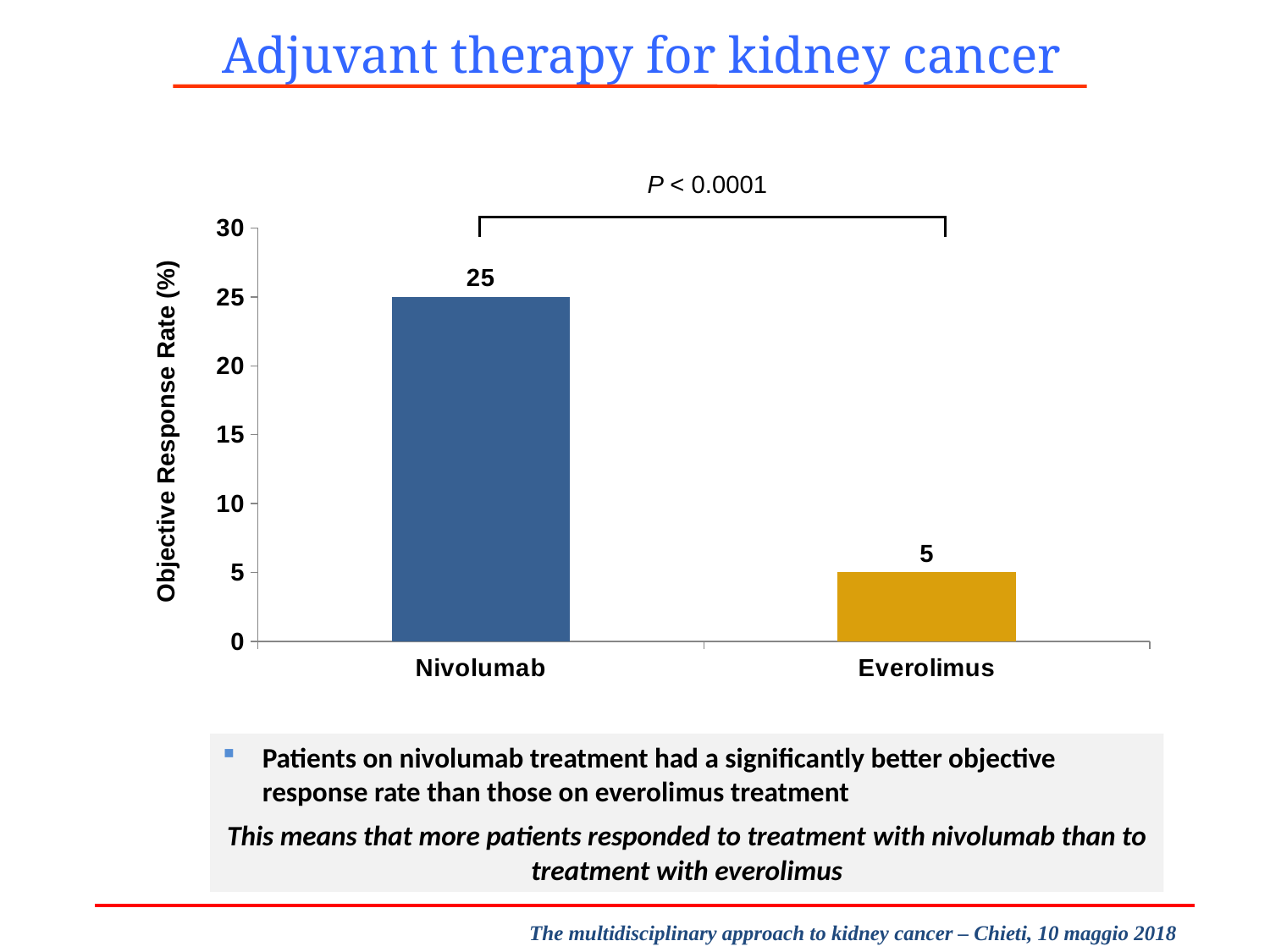
What is the objective response rate for Nivolumab? 25 What P value is shown above the chart? P < 0.0001 Is the value for Nivolumab greater or less than 20? greater How many treatments are shown on the chart? 2 Which treatment has the higher objective response rate? Nivolumab Is the objective response rate larger for Nivolumab or for Everolimus? Nivolumab Is the value for Everolimus greater or less than 10? less Which treatment has the lower objective response rate? Everolimus What kind of chart is shown on the slide? Bar chart What is the difference in objective response rate between Nivolumab and Everolimus? 20 What is the objective response rate for Everolimus? 5 What is the label of the y axis? Objective Response Rate (%)